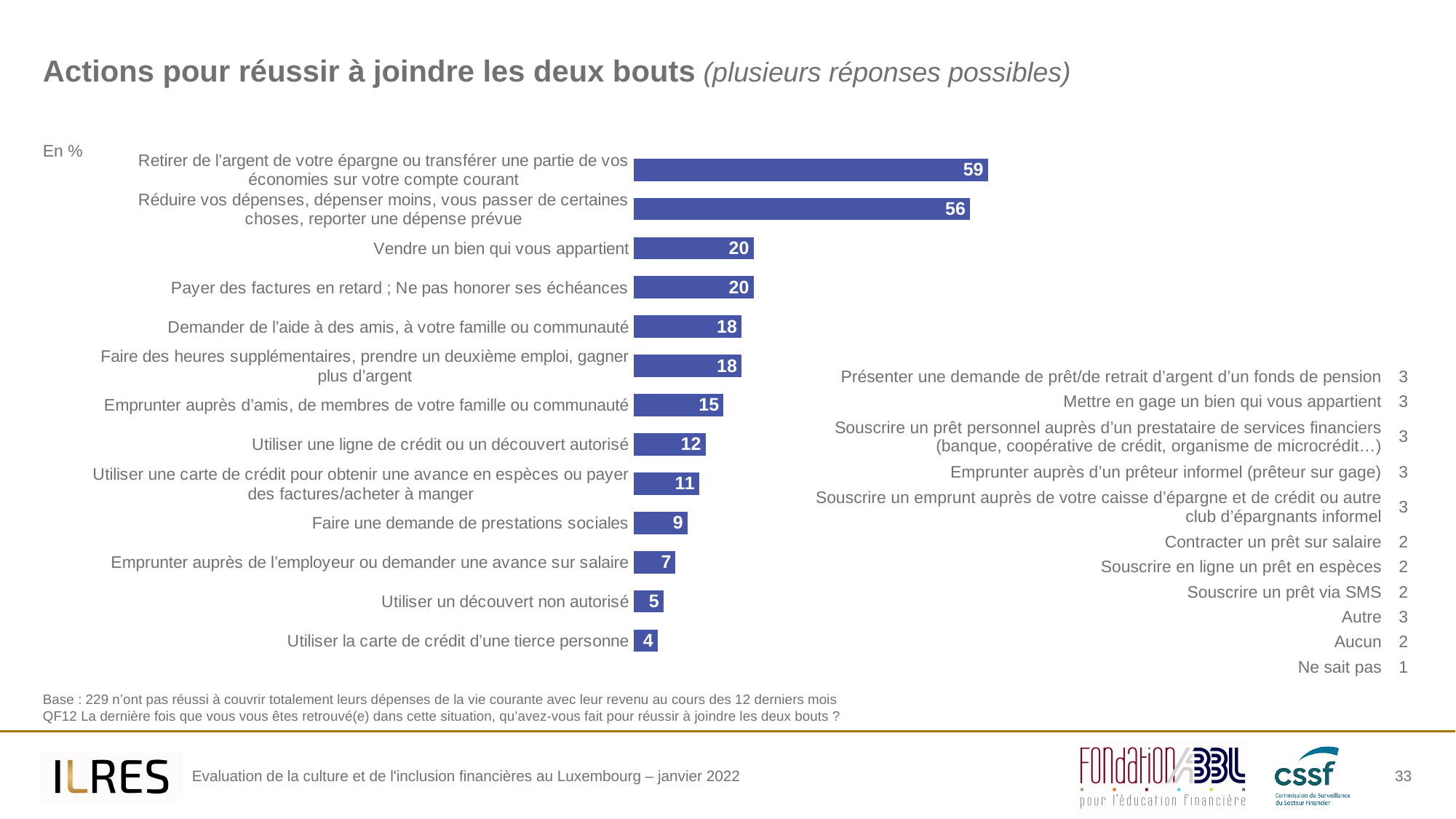
What is the value for "Faire des heures supplémentaires, prendre un deuxième emploi, gagner plus d'argent"? 18 What is the difference between the values for "Vendre un bien qui vous appartient" and "Emprunter auprès d'amis, de membres de votre famille ou communauté"? 5 Which action has the highest value in the bar chart? Retirer de l'argent de votre épargne ou transférer une partie de vos économies sur votre compte courant In what unit are the values in the chart expressed, according to the label at the top left? En % How many bars are plotted in the chart? 13 What is the value for "Utiliser une ligne de crédit ou un découvert autorisé"? 12 Which action has the lowest value among the bars in the chart? Utiliser la carte de crédit d'une tierce personne What type of chart is shown on the slide? Bar chart What is the value for "Utiliser un découvert non autorisé"? 5 What is the difference between the values for "Retirer de l'argent de votre épargne..." and "Réduire vos dépenses, dépenser moins..."? 3 What is the value for "Vendre un bien qui vous appartient"? 20 Which is larger: the value for "Faire une demande de prestations sociales" or for "Emprunter auprès de l'employeur ou demander une avance sur salaire"? Faire une demande de prestations sociales